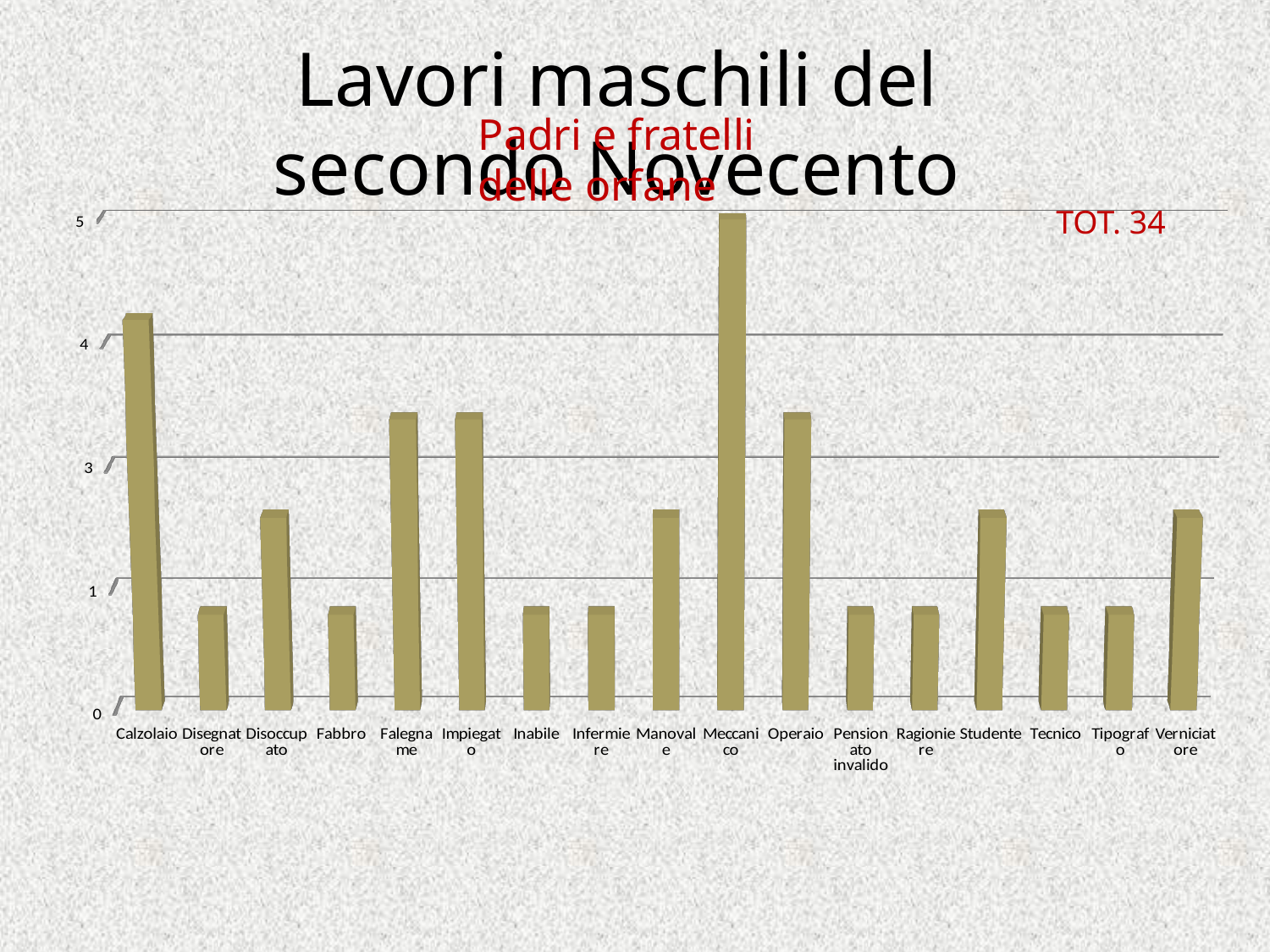
What kind of chart is shown on the slide? bar chart How many categories are shown on the x axis? 17 Is the value for Calzolaio greater or less than 3? greater What total is written in red on the slide? TOT. 34 Is the value for Meccanico greater or less than 4? greater Which category has the highest bar? Meccanico Which is larger, the value for Meccanico or the value for Calzolaio? Meccanico Which is larger, the value for Calzolaio or the value for Falegname? Calzolaio Is the value for Operaio greater or less than 4? less What is the title of the slide? Lavori maschili del secondo Novecento